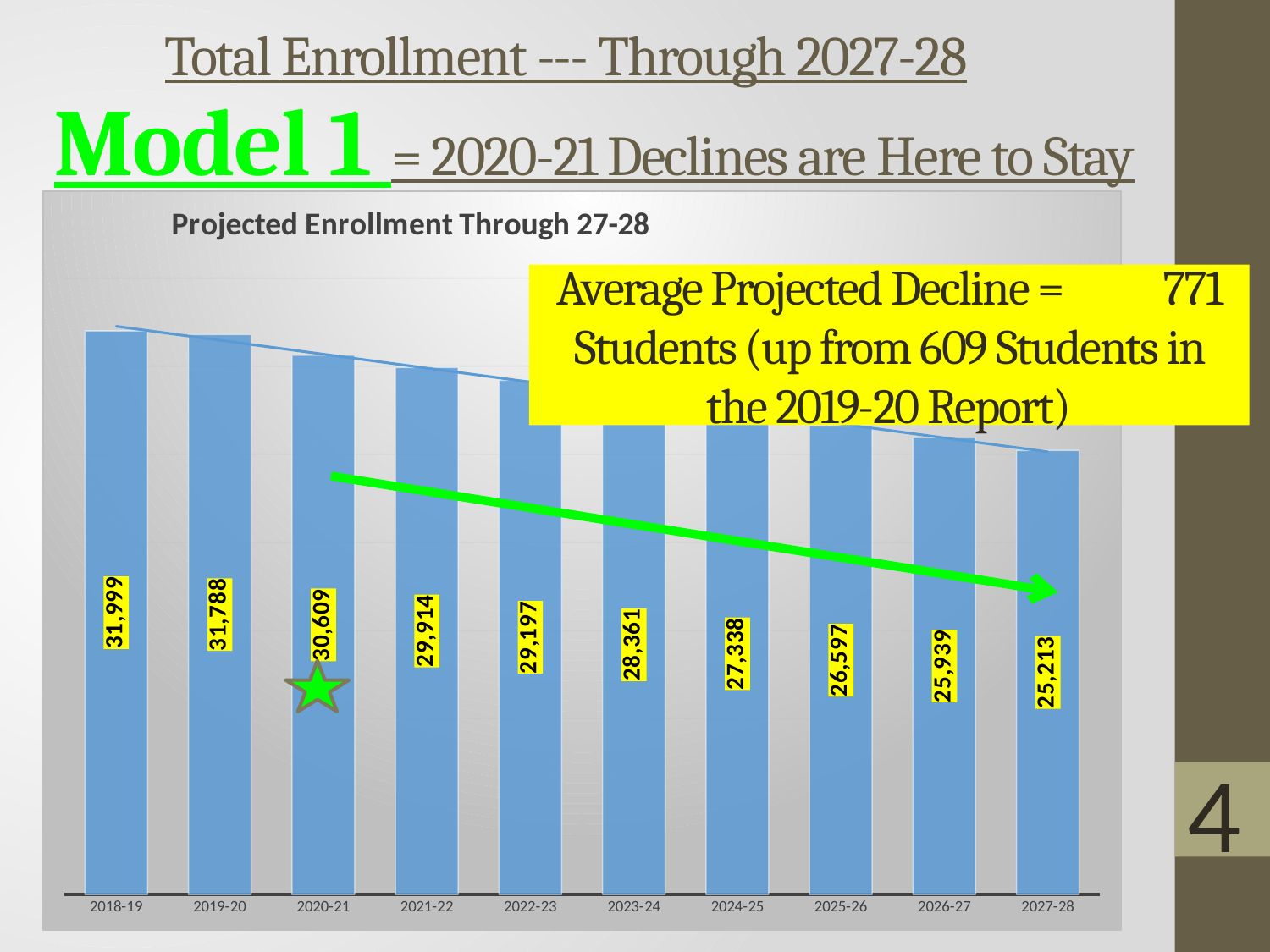
What is the difference in enrollment between 2019-20 and 2020-21? 1,179 Which is larger, the enrollment for 2021-22 or for 2024-25? 2021-22 What is the projected enrollment for 2027-28? 25,213 Which year has the highest enrollment in the chart? 2018-19 What kind of chart is shown on the slide? Bar chart How many school years are shown on the x axis of the chart? 10 Which year has the lowest enrollment in the chart? 2027-28 What is the projected enrollment for 2020-21? 30,609 Do the enrollment values rise or fall from 2018-19 to 2027-28? Fall What is the enrollment value shown for 2023-24? 28,361 What is the title of the chart? Projected Enrollment Through 27-28 What is the difference in enrollment between 2018-19 and 2027-28? 6,786